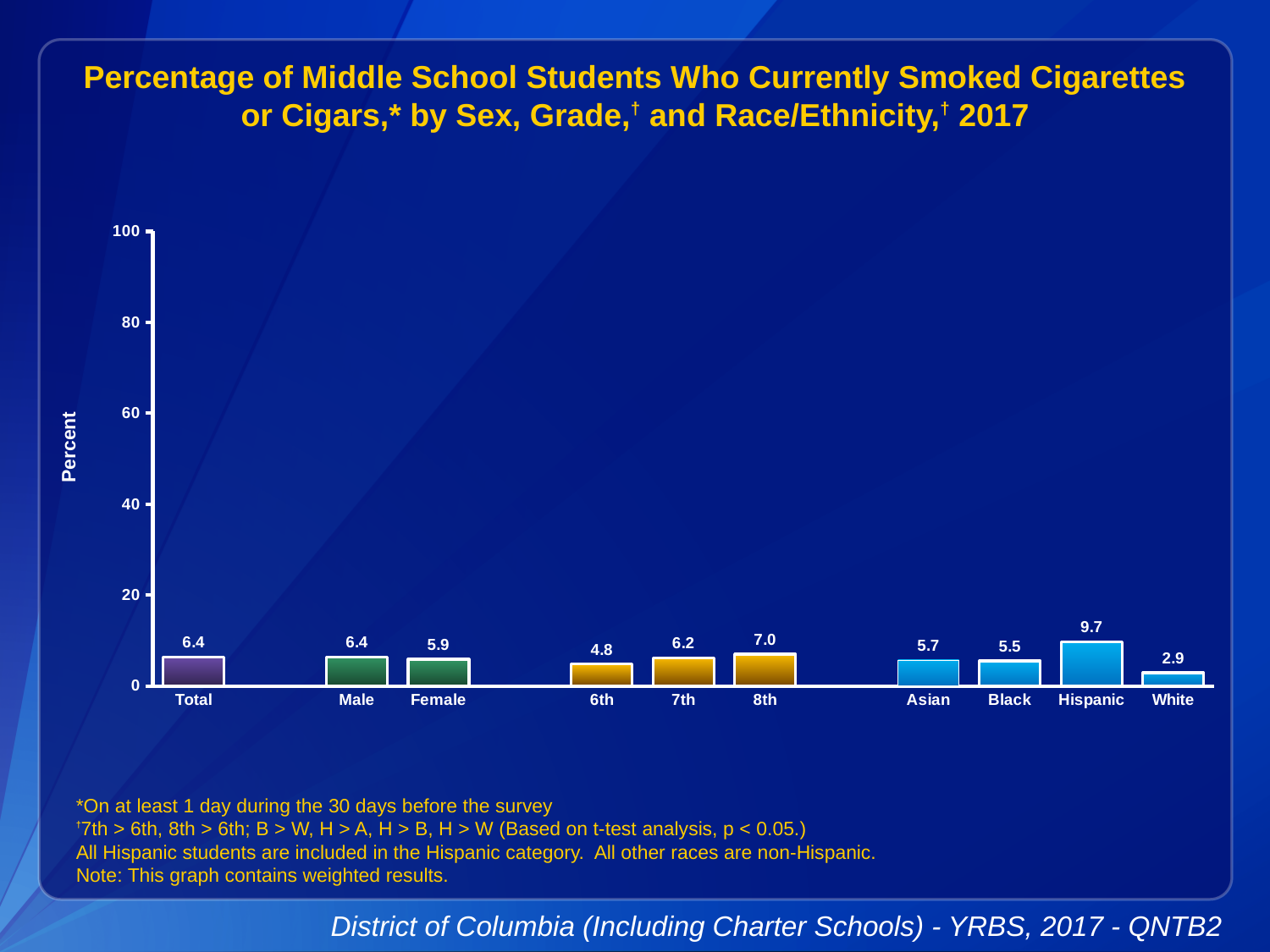
What is the value for Total? 6.4 Which category has the lowest value? White How many categories are shown on the x axis? 10 What is the difference between the values for Hispanic and White students? 6.8 Which category has the highest value? Hispanic Is the value for Hispanic students greater or less than 20? less What is the difference between the values for 8th grade and 6th grade students? 2.2 Which is larger, the value for Male or the value for Female? Male What is the value for 6th grade students? 4.8 Do the values rise or fall across the grade categories from 6th to 8th? rise What is the value for Hispanic students? 9.7 What kind of chart is this? bar chart